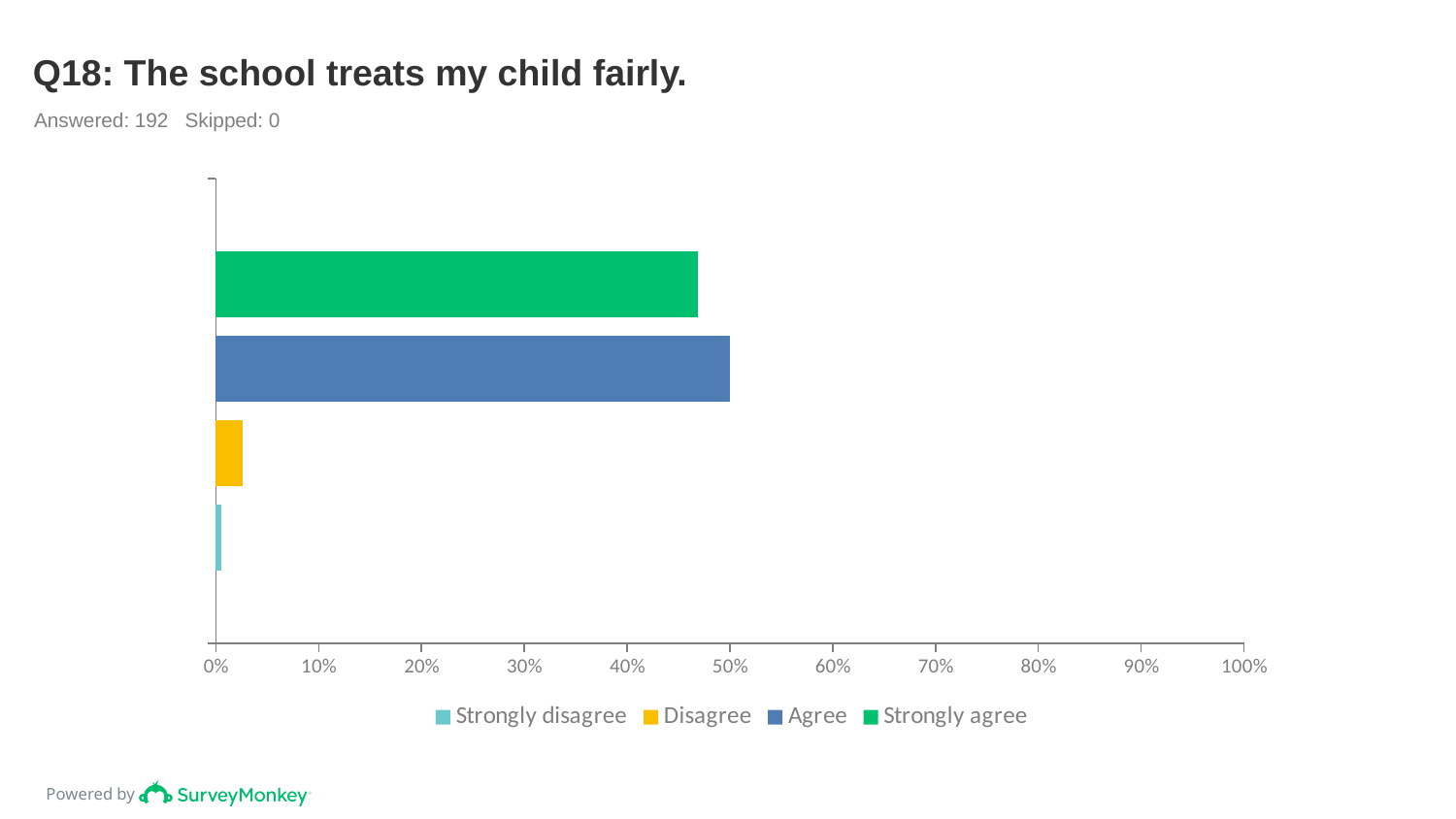
Is the value for Strongly agree greater or less than 40%? greater Which response category has the highest value? Agree Is the value for Disagree greater or less than 10%? less What kind of chart is shown on the slide? bar chart What is the title of the chart? Q18: The school treats my child fairly. Which response category has the lowest value? Strongly disagree How many series does the legend list? 4 How many bars are plotted in the chart? 4 Is the value for Agree greater or less than 30%? greater Which is larger, the value for Agree or the value for Strongly agree? Agree How many respondents answered the question according to the slide? 192 Which is larger, the value for Disagree or the value for Strongly disagree? Disagree